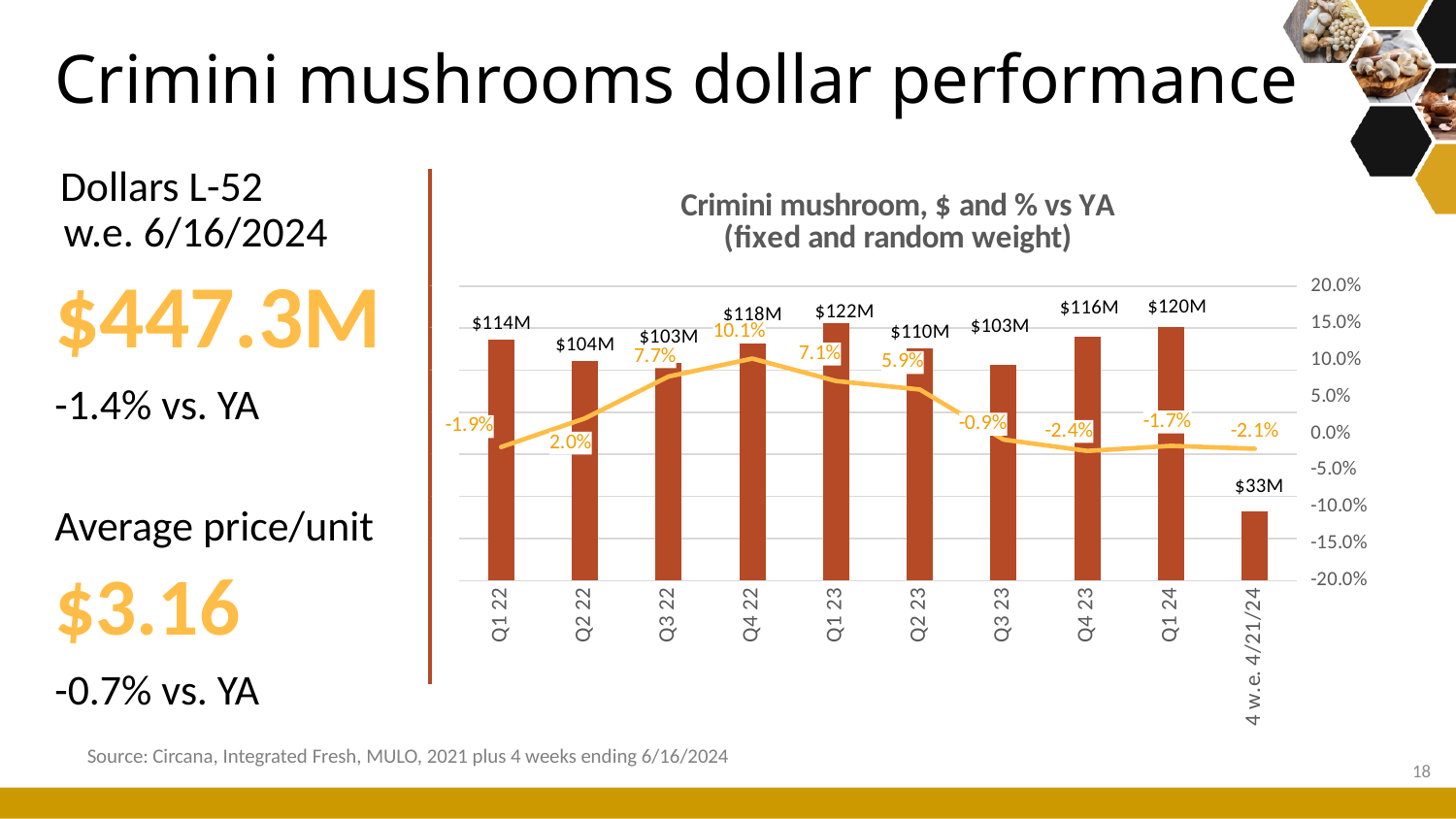
What is the % vs YA value shown for Q4 23? -2.4% Which has a larger dollar value, Q4 23 or Q1 24? Q1 24 How many periods are shown on the x axis? 10 What kind of chart is this? Combined bar and line chart What is the % vs YA value shown for Q4 22? 10.1% What is the difference in dollar value between Q1 23 and Q2 23? $12M Which quarter has the highest dollar value? Q1 23 What is the title of the chart? Crimini mushroom, $ and % vs YA (fixed and random weight) Which period has the lowest dollar value? 4 w.e. 4/21/24 What is the dollar value shown for Q1 23? $122M What is the dollar value shown for the 4 w.e. 4/21/24 period? $33M Which period has the highest % vs YA value? Q4 22